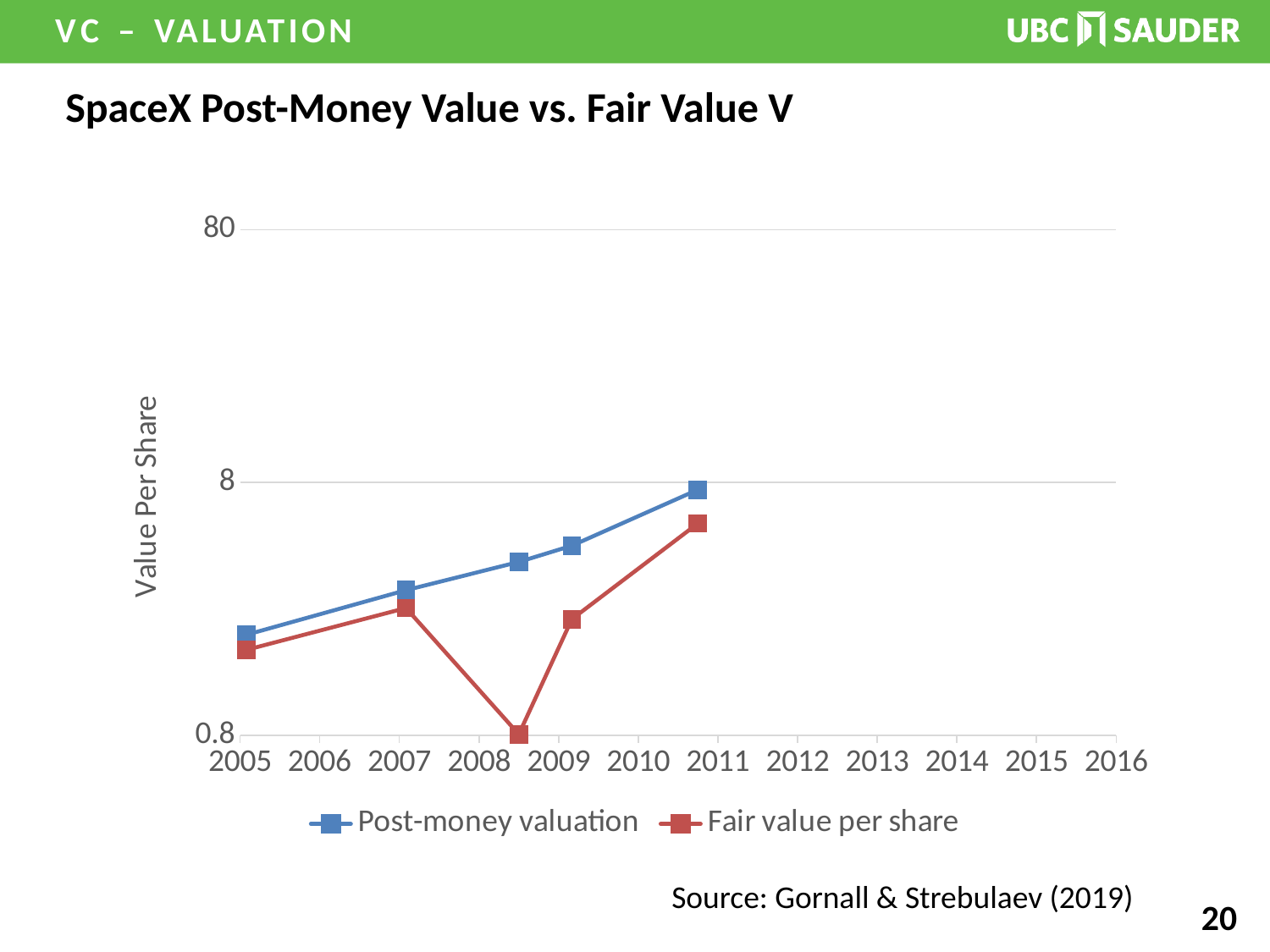
Does the Post-money valuation series rise or fall over time from 2005 to 2011? rise How many series does the legend list? 2 Is the Fair value per share value at 2011 greater or less than 8? less What kind of chart is shown on the slide? line chart Which colour is used for the Fair value per share series? red How many data points are plotted for the Post-money valuation series? 5 Is the Fair value per share value at 2009 greater or less than 8? less In which year does the Fair value per share series reach its lowest point? 2008 What is the label on the vertical axis of the chart? Value Per Share Around 2009, which series has the higher value: Post-money valuation or Fair value per share? Post-money valuation Is the Post-money valuation value at 2005 greater or less than 0.8? greater At which year is the Post-money valuation series at its highest? 2010